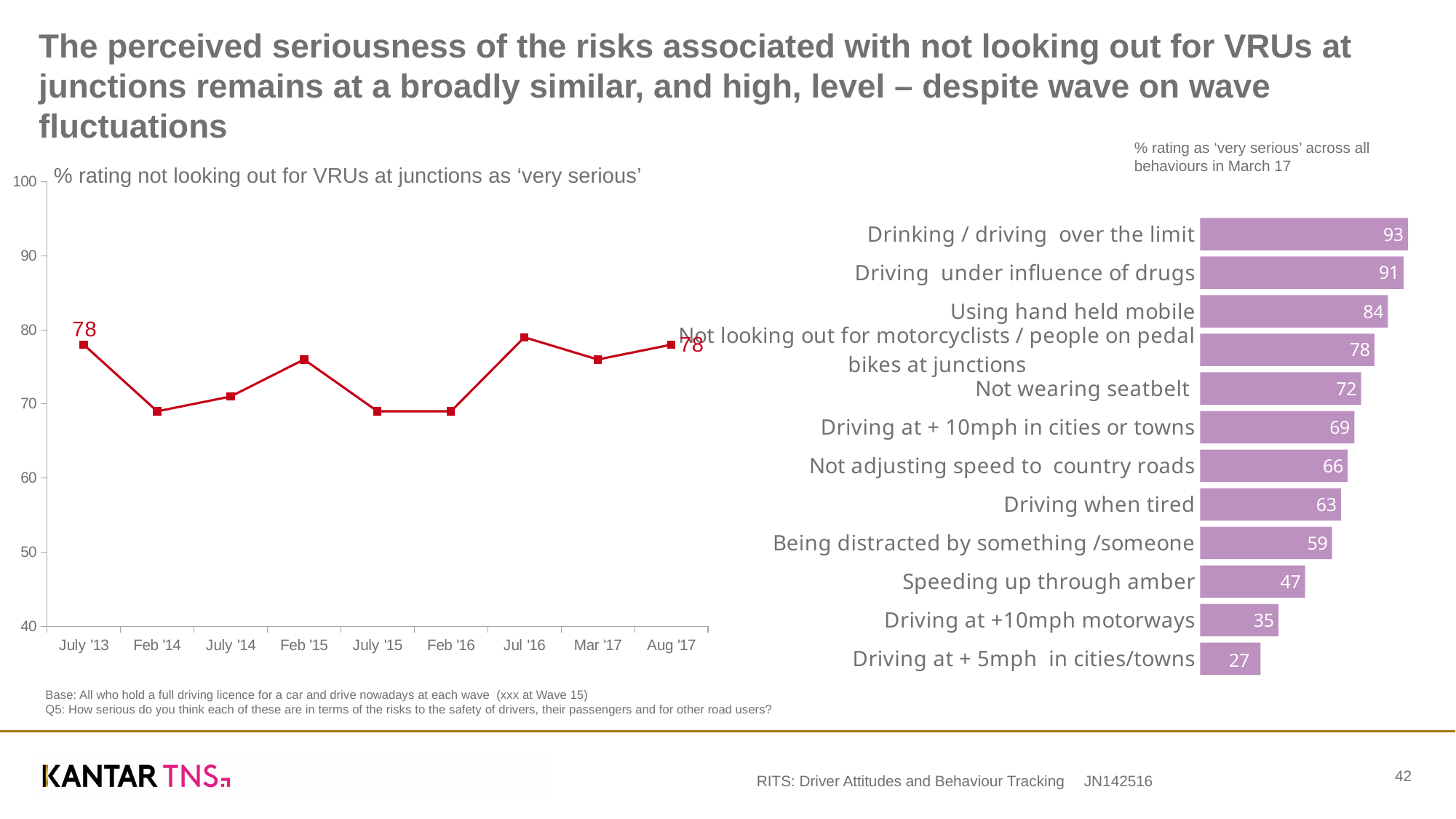
What type of chart is shown on the left of the slide? Line chart In the bar chart on the right, what is the value for Drinking / driving over the limit? 93 How many behaviours are listed in the bar chart on the right? 12 In the bar chart on the right, what is the value for Speeding up through amber? 47 In the line chart on the left, what is the value for Aug '17? 78 How many time points are plotted in the line chart on the left? 9 In the bar chart on the right, which behaviour has the highest value? Drinking / driving over the limit In the line chart on the left, is the value for Jul '16 greater or less than 70? greater In the bar chart on the right, which behaviour has the lowest value? Driving at + 5mph in cities/towns In the bar chart on the right, what is the difference between Using hand held mobile and Driving when tired? 21 In the bar chart on the right, which is larger: Driving at + 10mph in cities or towns or Driving at +10mph motorways? Driving at + 10mph in cities or towns In the bar chart on the right, what is the value for Not wearing seatbelt? 72